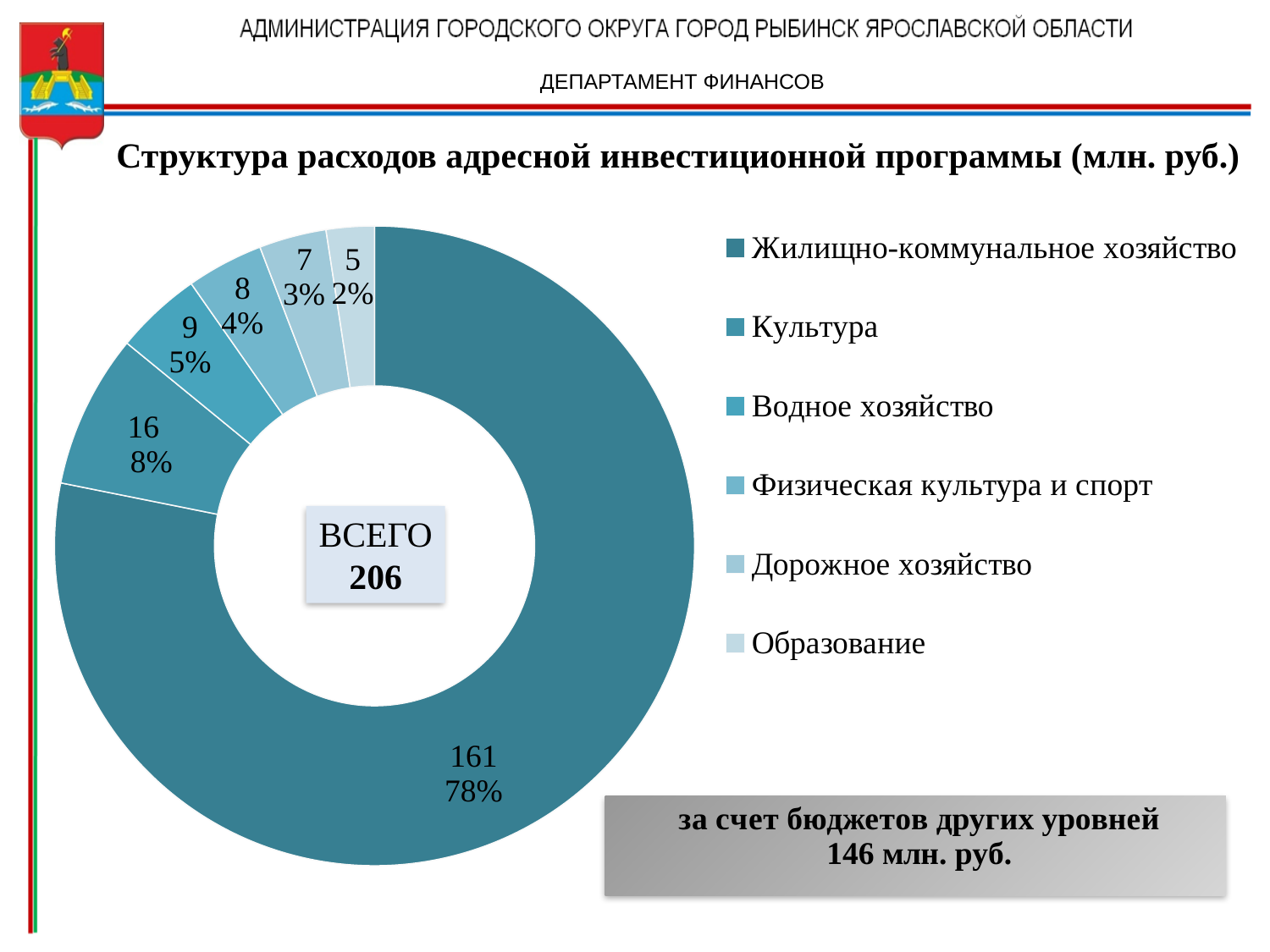
What is the value for Жилищно-коммунальное хозяйство? 161 What is the value for Образование? 5 What type of chart is shown on the slide? doughnut (pie) chart How many categories does the legend list? 6 Which category has the smallest value? Образование What is the difference between the values for Жилищно-коммунальное хозяйство and Культура? 145 What is the value for Водное хозяйство? 9 What share of the total does Жилищно-коммунальное хозяйство represent? 78% What is the value for Культура? 16 Which is larger, the value for Физическая культура и спорт or the value for Дорожное хозяйство? Физическая культура и спорт Which category has the largest value? Жилищно-коммунальное хозяйство What share of the total does Дорожное хозяйство represent? 3%